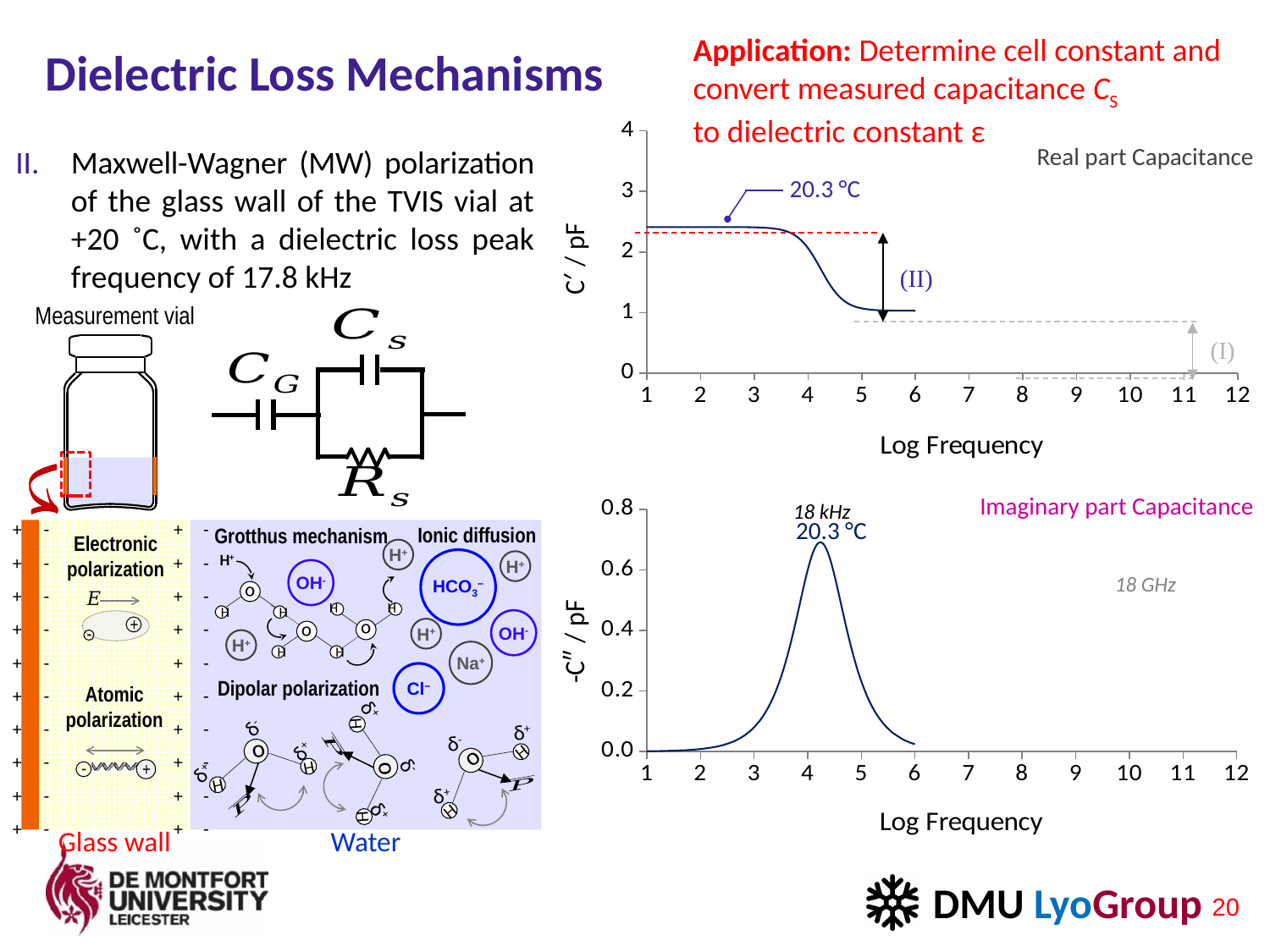
What temperature is annotated on the 'Real part Capacitance' chart? 20.3 °C In the 'Real part Capacitance' chart, is the value at Log Frequency 2 greater or less than 2? greater In the 'Imaginary part Capacitance' chart, does the plotted value rise or fall as Log Frequency increases from 5 to 6? fall In the 'Real part Capacitance' chart, is the value at Log Frequency 2 larger or smaller than the value at Log Frequency 6? larger In the 'Imaginary part Capacitance' chart, is the value at Log Frequency 6 greater or less than 0.2? less In the 'Imaginary part Capacitance' chart, does the plotted value rise or fall as Log Frequency increases from 1 to 4? rise What kind of chart is the 'Real part Capacitance' chart? line chart In the 'Real part Capacitance' chart, is the value at Log Frequency 2 greater or less than 3? less In the 'Real part Capacitance' chart, does the plotted value rise or fall as Log Frequency increases from 3 to 5? fall What is the x-axis title of the 'Imaginary part Capacitance' chart? Log Frequency What kind of chart is the 'Imaginary part Capacitance' chart? line chart